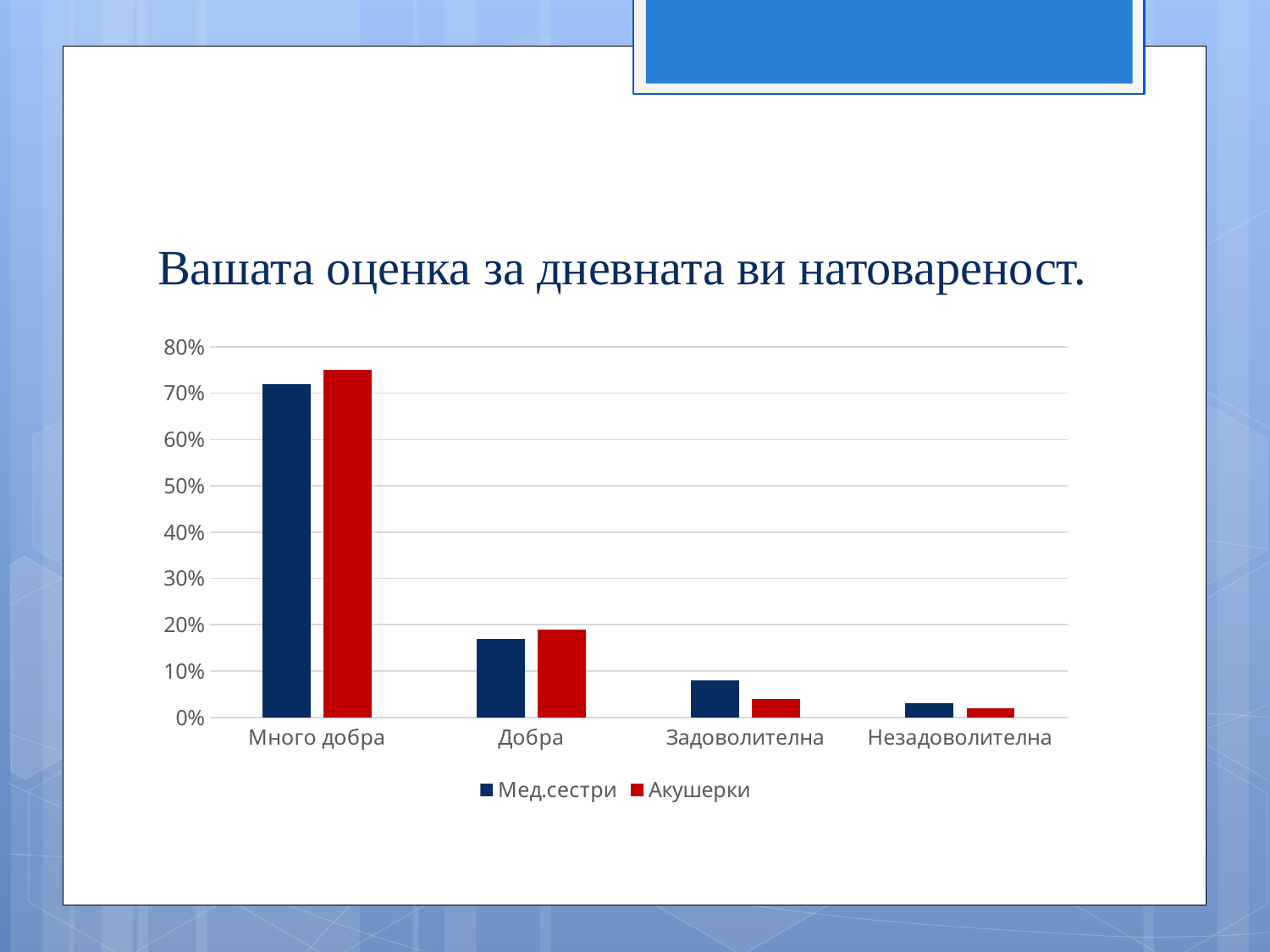
How many series does the legend list? 2 Which category has the highest value for Мед.сестри? Много добра Is the value for Акушерки in the Много добра category greater or less than 70%? greater In the Много добра category, which series has the larger value, Мед.сестри or Акушерки? Акушерки What colour are the bars for the Акушерки series? red Is the value for Мед.сестри in the Задоволителна category greater or less than 10%? less What kind of chart is shown on the slide? bar chart In the Задоволителна category, which series has the larger value, Мед.сестри or Акушерки? Мед.сестри How many categories are shown on the x axis? 4 Is the value for Мед.сестри in the Добра category greater or less than 20%? less Which category has the lowest value for Акушерки? Незадоволителна Do the values for Мед.сестри rise or fall from left to right along the x axis? fall